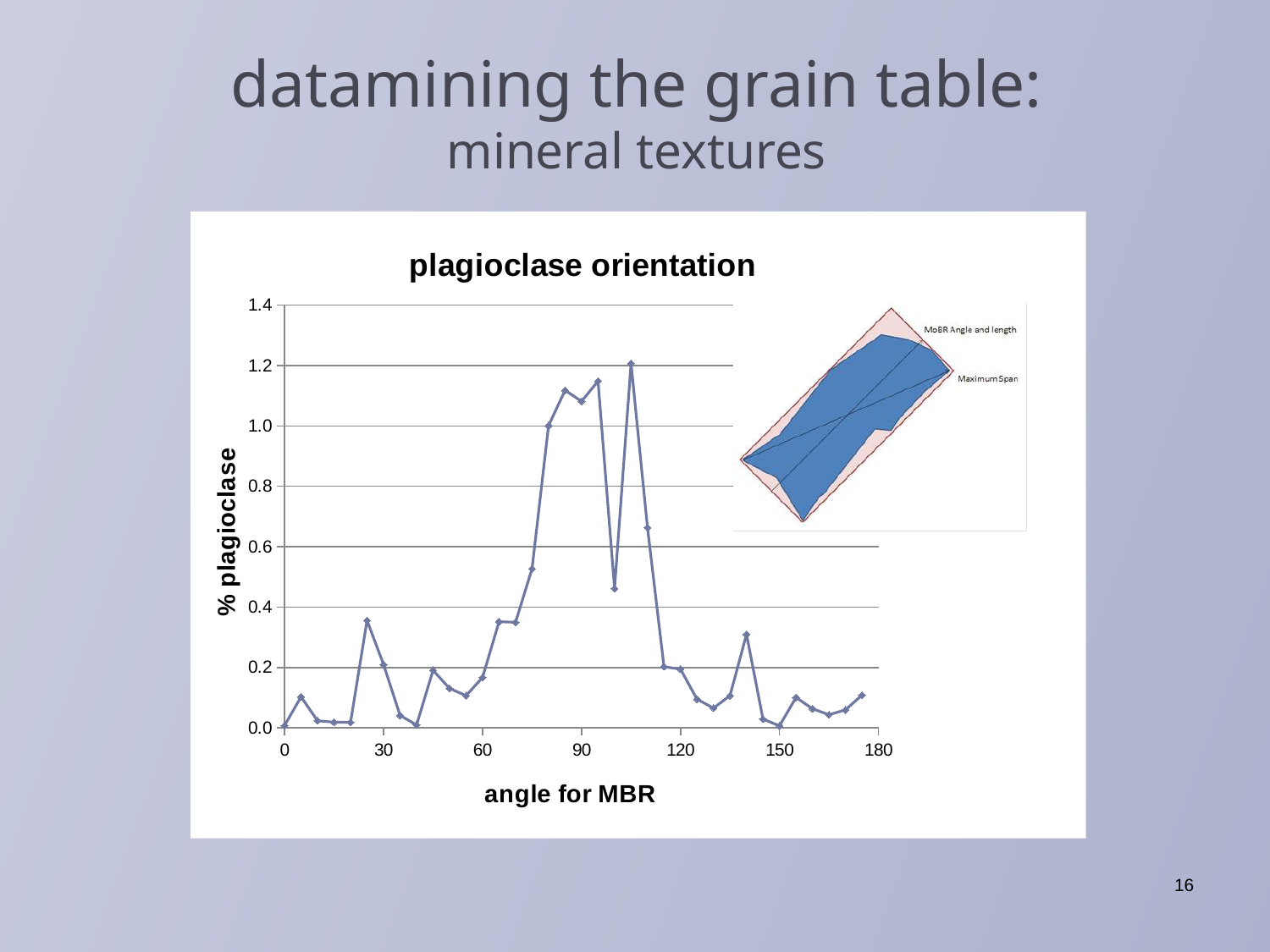
Which has the larger % plagioclase, angle 140 or angle 150? 140 Is the value for angle 105 greater or less than 1.0? greater Is the value for angle 150 greater or less than 0.2? less Is the value for angle 85 greater or less than 1.0? greater What is the title of the chart? plagioclase orientation What kind of chart is shown on the slide? line chart At which angle for MBR does the % plagioclase reach its highest value? 105 Which has the larger % plagioclase, angle 105 or angle 100? 105 Do the values rise or fall as the angle goes from 60 to 85? rise What is the label of the y axis? % plagioclase